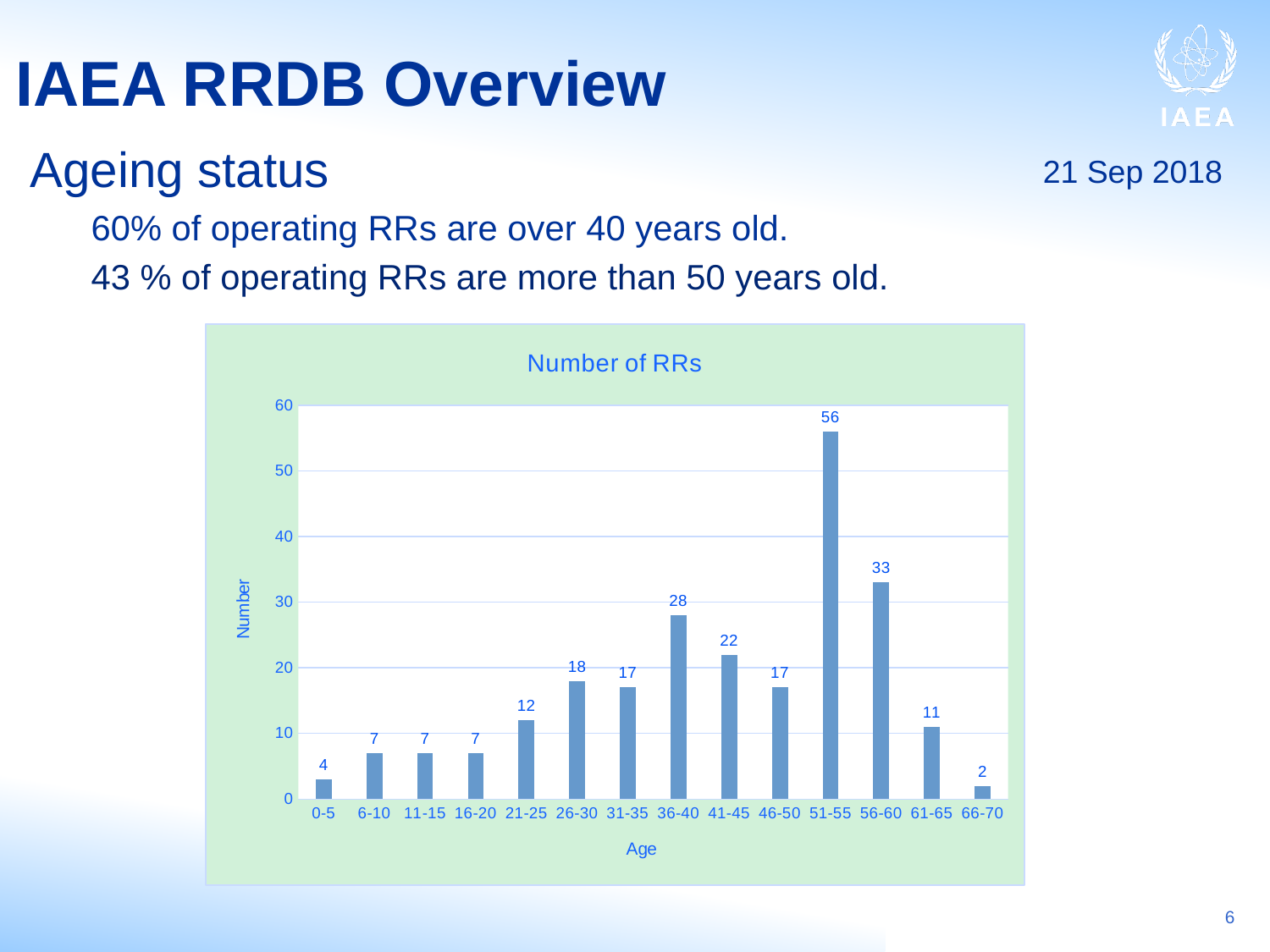
Which age group has the lowest number of RRs? 66-70 Which age group has the highest number of RRs? 51-55 Is the number of RRs in the 56-60 age group greater or less than 30? greater What kind of chart is shown on the slide? bar chart What is the number of RRs in the 0-5 age group? 4 What is the number of RRs in the 36-40 age group? 28 What is the difference between the number of RRs in the 51-55 and 56-60 age groups? 23 What is the number of RRs in the 51-55 age group? 56 What is the label of the y axis? Number Which age group has more RRs, 41-45 or 46-50? 41-45 How many age groups are shown on the x axis? 14 What is the title of the chart? Number of RRs